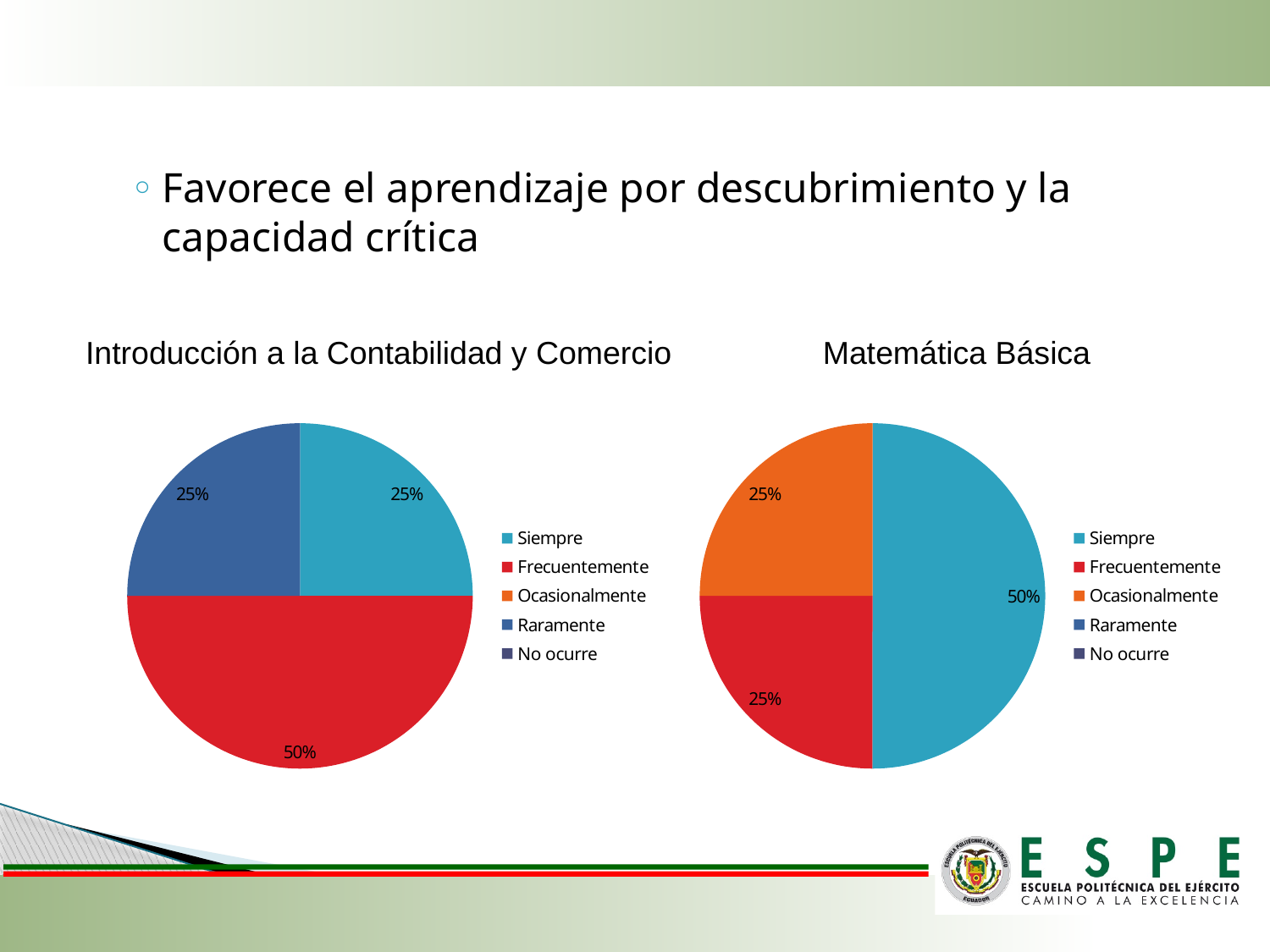
In the 'Introducción a la Contabilidad y Comercio' chart, what share does Frecuentemente have? 50% In the 'Matemática Básica' chart, what share does Ocasionalmente have? 25% In the 'Introducción a la Contabilidad y Comercio' chart, which is larger, Frecuentemente or Siempre? Frecuentemente In the 'Introducción a la Contabilidad y Comercio' chart, which category has the largest slice? Frecuentemente In the 'Matemática Básica' chart, what share does Siempre have? 50% How many entries does the legend of the 'Introducción a la Contabilidad y Comercio' chart list? 5 How many slices does the 'Matemática Básica' pie chart have? 3 What type of chart is used for 'Matemática Básica'? Pie chart In the 'Matemática Básica' chart, which category has the largest slice? Siempre In the 'Introducción a la Contabilidad y Comercio' chart, what share does Raramente have? 25% In the 'Introducción a la Contabilidad y Comercio' chart, what share does Siempre have? 25% In the 'Matemática Básica' chart, what is the difference between the Siempre and Frecuentemente shares? 25%